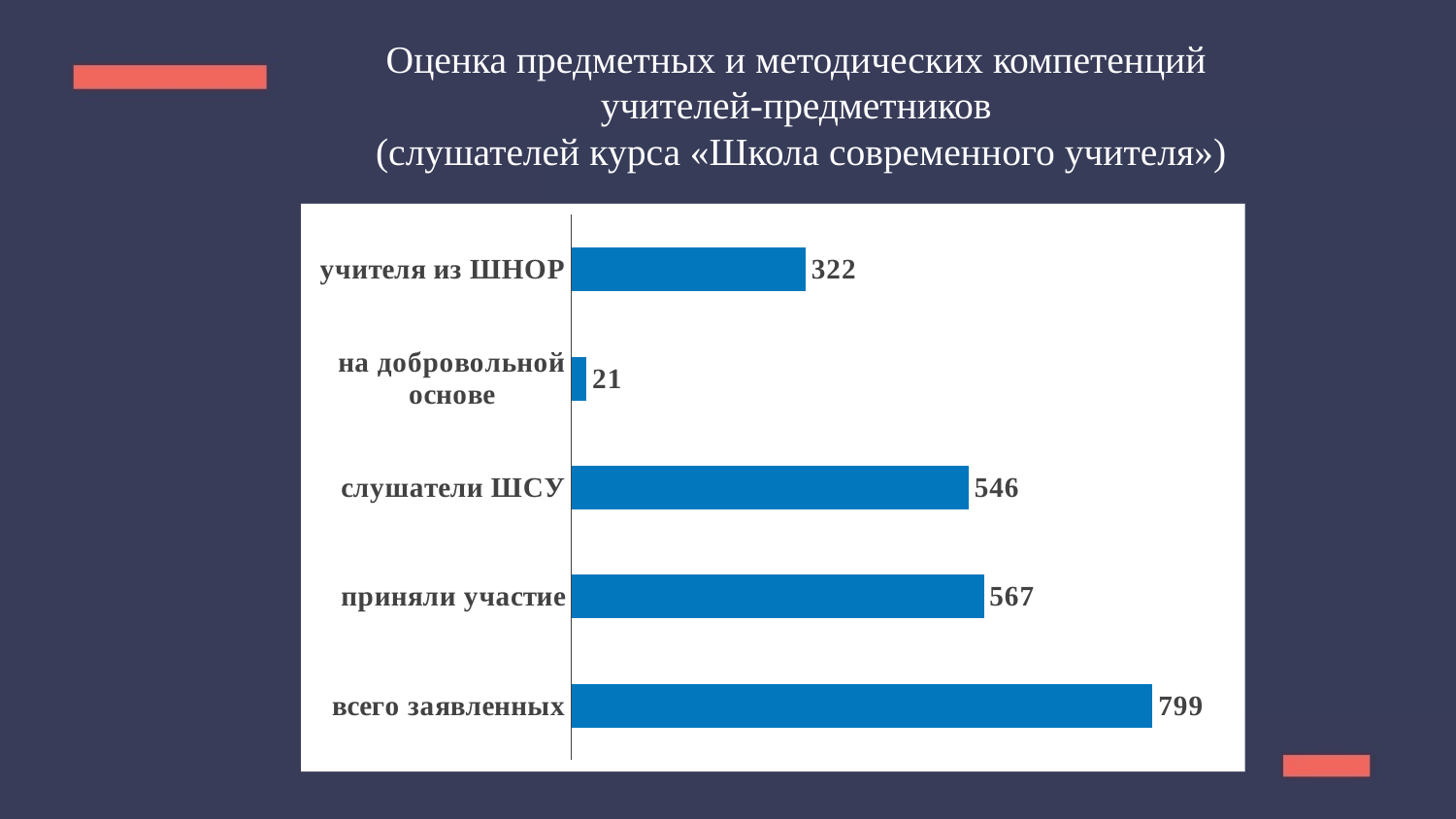
Which is larger: «учителя из ШНОР» or «слушатели ШСУ»? слушатели ШСУ Which category has the lowest value? на добровольной основе What is the value for «учителя из ШНОР»? 322 What is the value for «приняли участие»? 567 What is the value for «всего заявленных»? 799 Which category has the highest value? всего заявленных What is the difference between «учителя из ШНОР» and «на добровольной основе»? 301 What is the value for «слушатели ШСУ»? 546 What is the difference between «всего заявленных» and «приняли участие»? 232 How many categories are shown in the chart? 5 What is the value for «на добровольной основе»? 21 What kind of chart is shown on the slide? bar chart